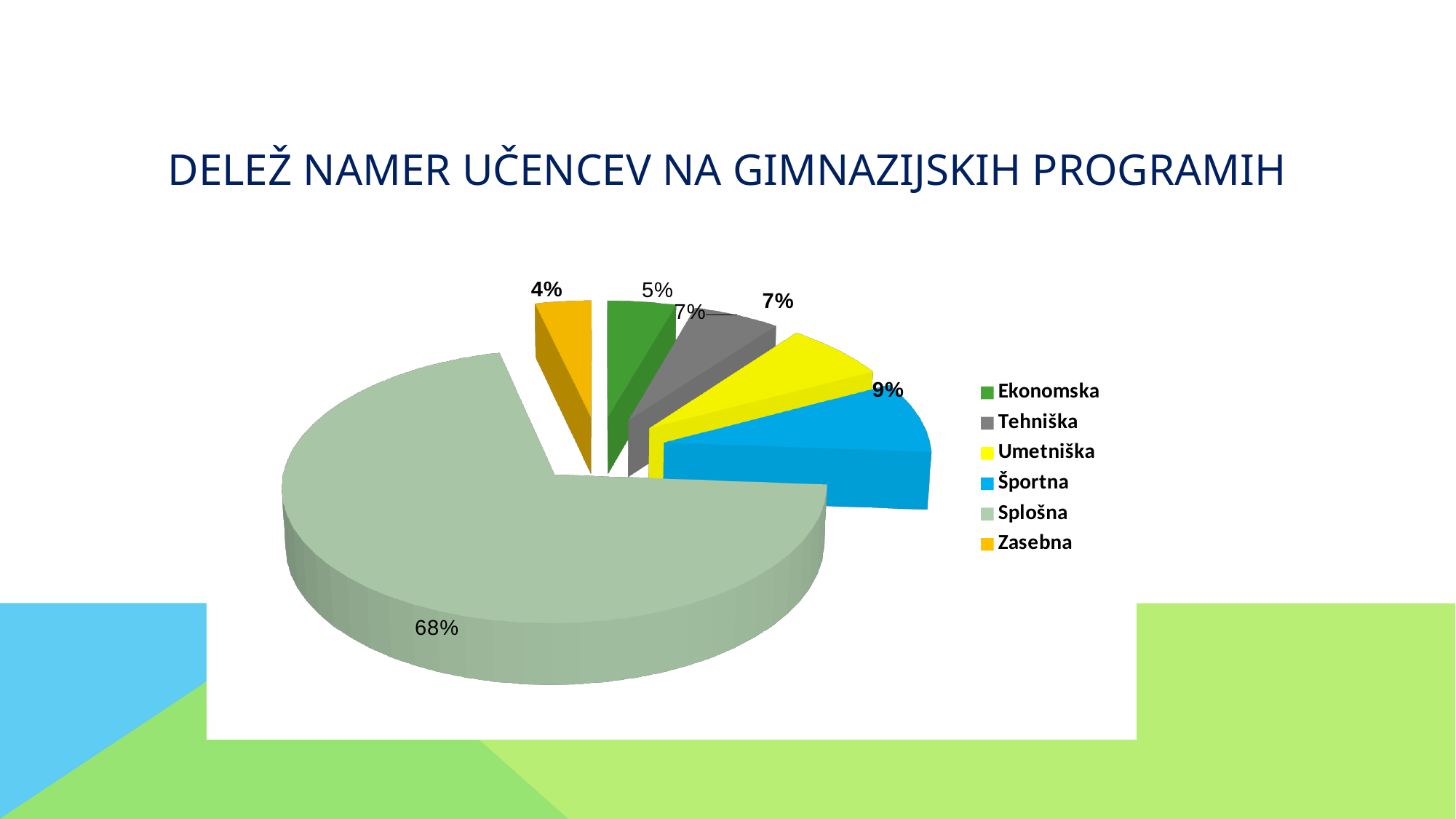
Which category has the smallest share of the pie? Zasebna Which has a larger share, Športna or Ekonomska? Športna How many categories does the legend list? 6 What share of the pie does Splošna have? 68% What share of the pie does Zasebna have? 4% What is the difference between the shares of Splošna and Športna? 59% What share of the pie does Ekonomska have? 5% What share of the pie does Umetniška have? 7% Which category has the largest share of the pie? Splošna What is the title of the chart? DELEŽ NAMER UČENCEV NA GIMNAZIJSKIH PROGRAMIH What kind of chart is shown on the slide? pie chart What share of the pie does Športna have? 9%